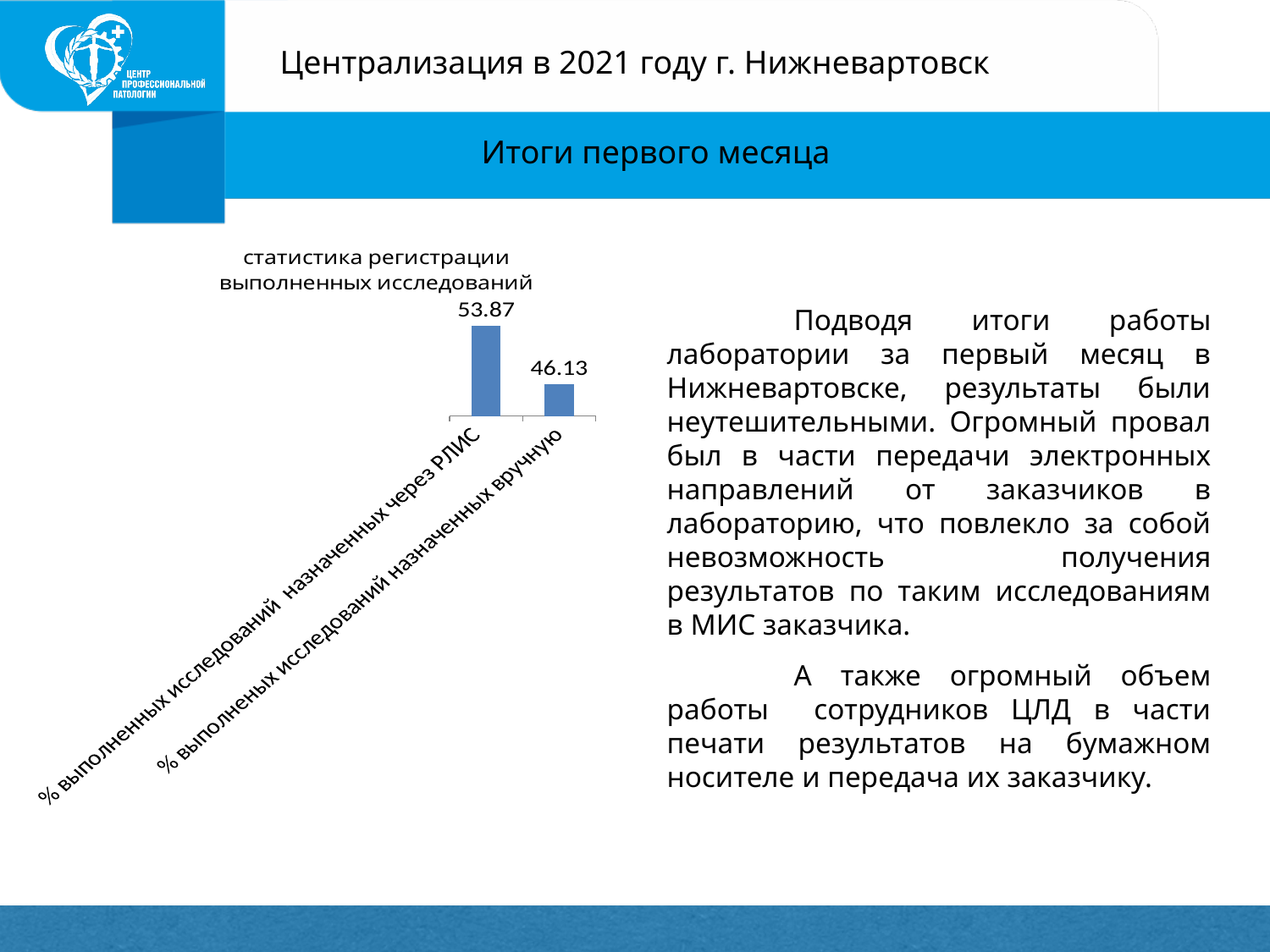
What is the value for '% выполненых исследований назначенных вручную'? 46.13 Which category has the lowest value in the chart? % выполненых исследований назначенных вручную Which is larger: the value for studies assigned through РЛИС or the value for studies assigned manually (вручную)? % выполненных исследований назначенных через РЛИС Which category has the highest value in the chart? % выполненных исследований назначенных через РЛИС Do the values rise or fall from the left bar to the right bar? Fall What kind of chart is shown on the slide? Bar chart What is the title of the chart? статистика регистрации выполненных исследований What is the difference between the value for studies assigned through РЛИС and the value for studies assigned manually (вручную)? 7.74 What is the value for '% выполненных исследований назначенных через РЛИС'? 53.87 How many categories are shown in the chart? 2